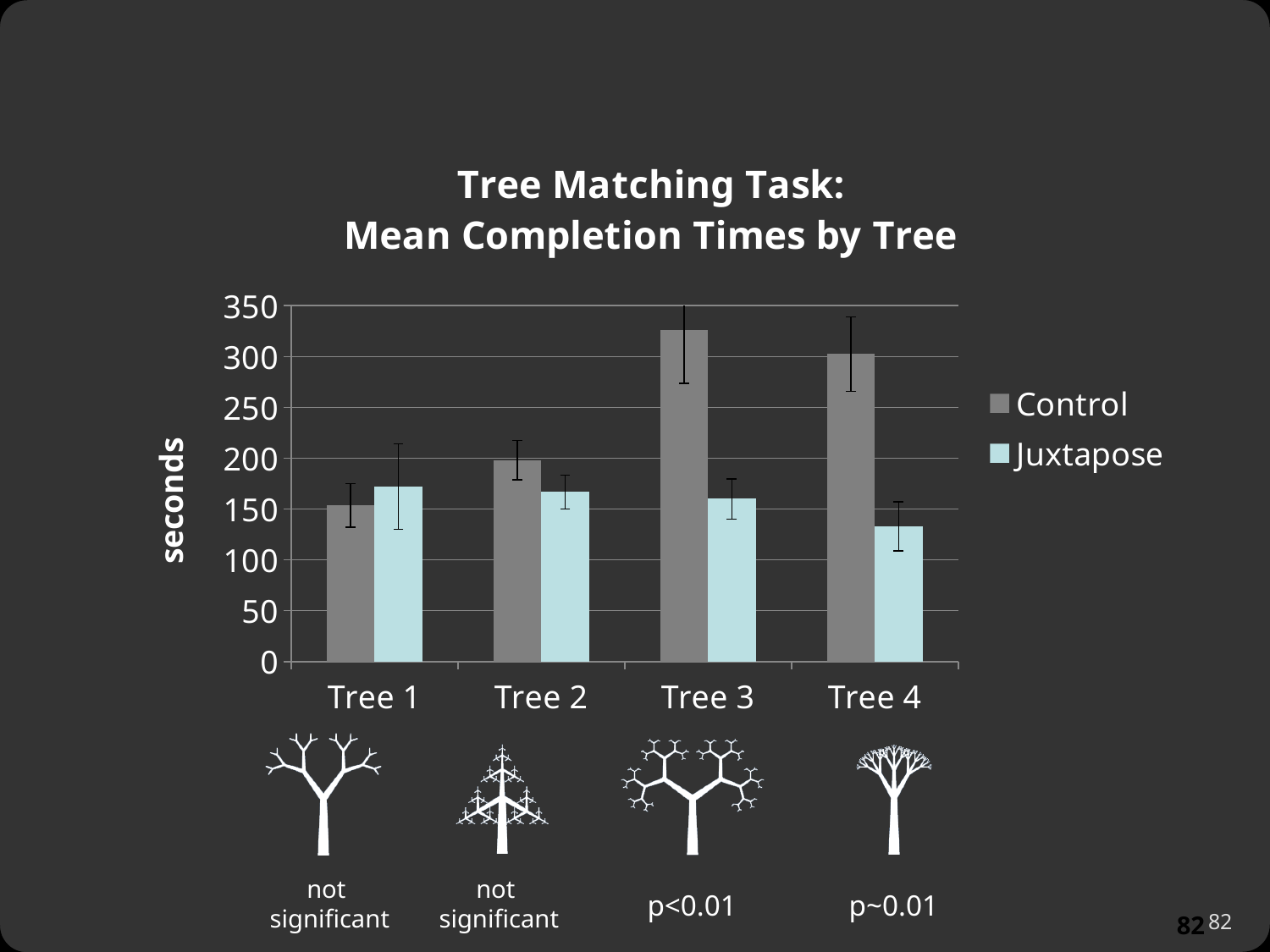
For Tree 1, which series has the larger value, Control or Juxtapose? Juxtapose Which tree has the highest Control completion time? Tree 3 How many tree categories are shown on the x axis? 4 Is the Control value for Tree 1 greater or less than 200? less What is the label on the y axis? seconds Is the Juxtapose value for Tree 4 greater or less than 150? less What kind of chart is shown on the slide? bar chart How many series does the legend list? 2 Which tree has the lowest Control completion time? Tree 1 Is the Control value for Tree 3 greater or less than 300? greater For Tree 3, which series has the larger value, Control or Juxtapose? Control Which tree has the lowest Juxtapose completion time? Tree 4